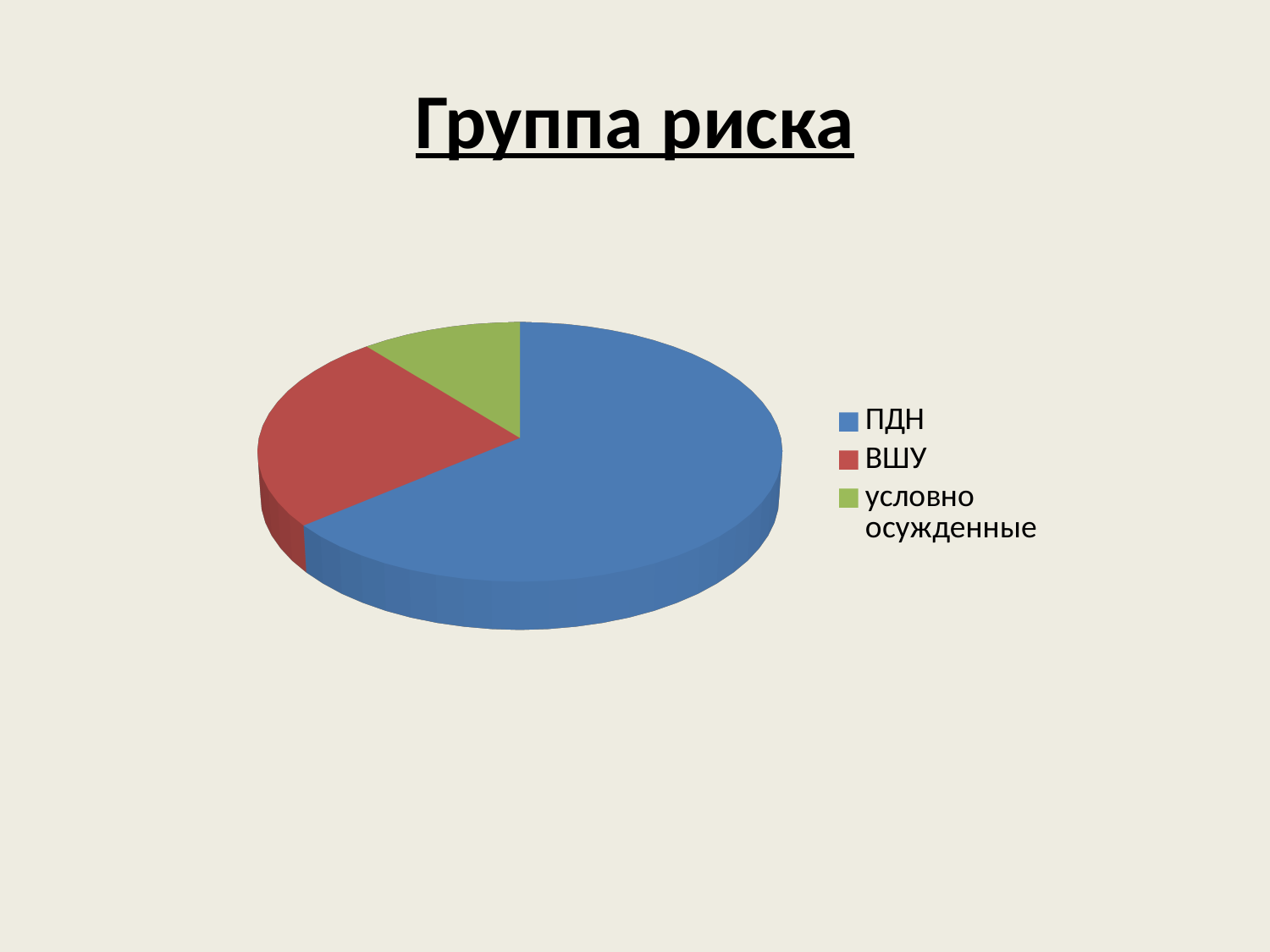
Which category has the largest slice of the pie? ПДН Which colour represents ВШУ in the pie chart? red How many categories does the pie chart show? 3 What is the title of the chart on the slide? Группа риска What kind of chart is shown on the slide? pie chart Does the ПДН slice take up more or less than half of the pie? more How many entries does the legend list? 3 Which slice is larger, ПДН or ВШУ? ПДН Which category has the smallest slice of the pie? условно осужденные Which slice is larger, ВШУ or условно осужденные? ВШУ